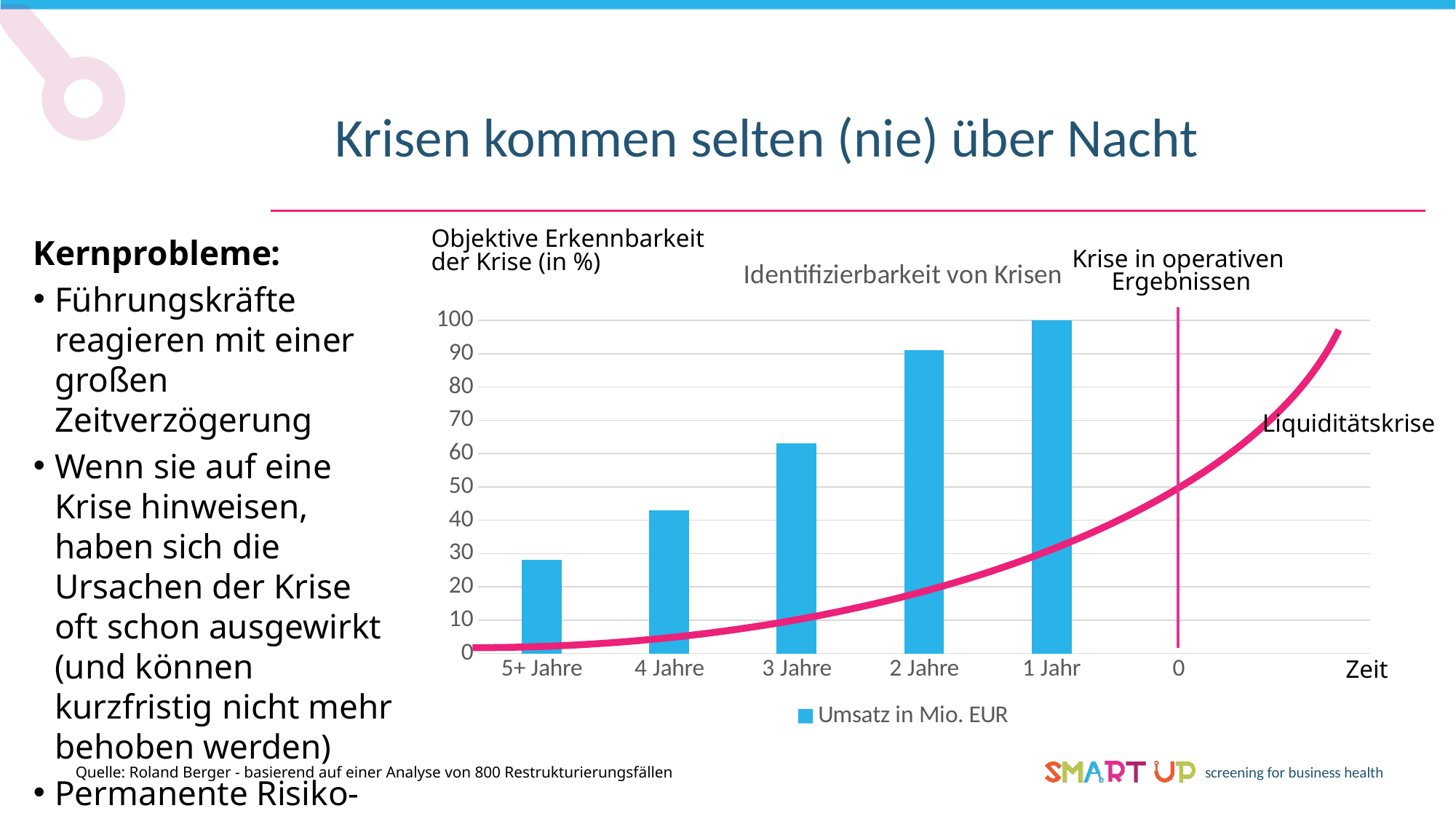
Which bar is taller, '2 Jahre' or '3 Jahre'? 2 Jahre Is the value for '5+ Jahre' greater or less than 30? less How many bars are plotted in the chart? 5 Do the bar values rise or fall from '5+ Jahre' to '1 Jahr'? rise Is the value for '4 Jahre' greater or less than 40? greater How many series does the chart legend list? 1 What is the value of the bar for '1 Jahr'? 100 Which category has the lowest bar? 5+ Jahre Which category has the highest bar? 1 Jahr Is the value for '3 Jahre' greater or less than 70? less What type of chart is used to show the 'Umsatz in Mio. EUR' series? bar chart What is the title of the chart? Identifizierbarkeit von Krisen